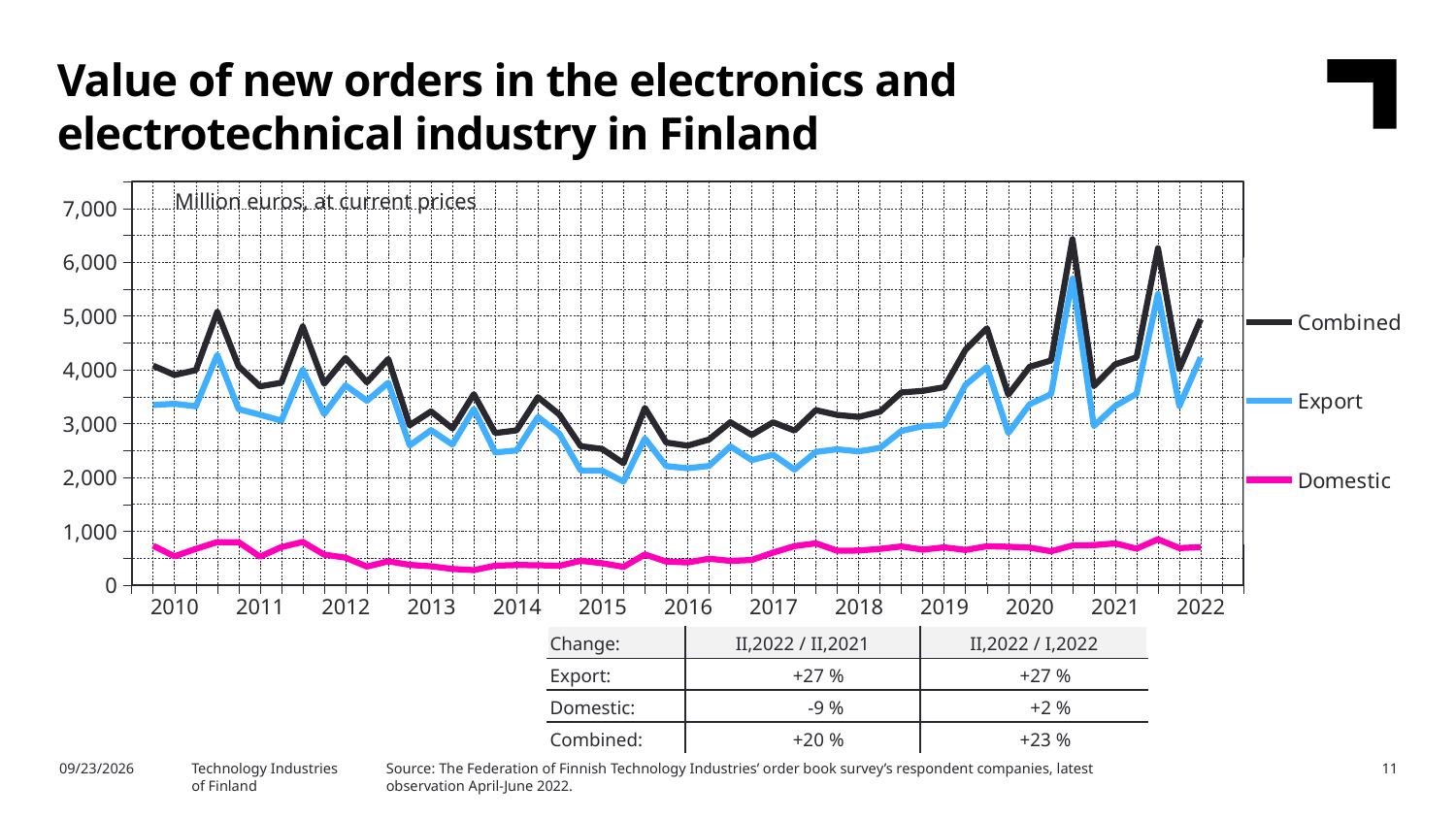
Which series has the lowest values throughout the chart? Domestic How many series does the chart's legend list? 3 Which is larger in 2019, the Export value or the Domestic value? Export How many years are labelled on the x axis? 13 Is the value for Export at the start of 2015 greater or less than 3,000? less Which series has the highest values throughout the chart? Combined Is the value for Domestic in 2010 greater or less than 1,000? less Between 2012 and 2015, does the Combined line generally rise or fall? fall Is the peak value of the Combined line in 2020 greater or less than 6,000? greater What unit label is shown at the top of the chart area? Million euros, at current prices What kind of chart is shown on the slide? line chart